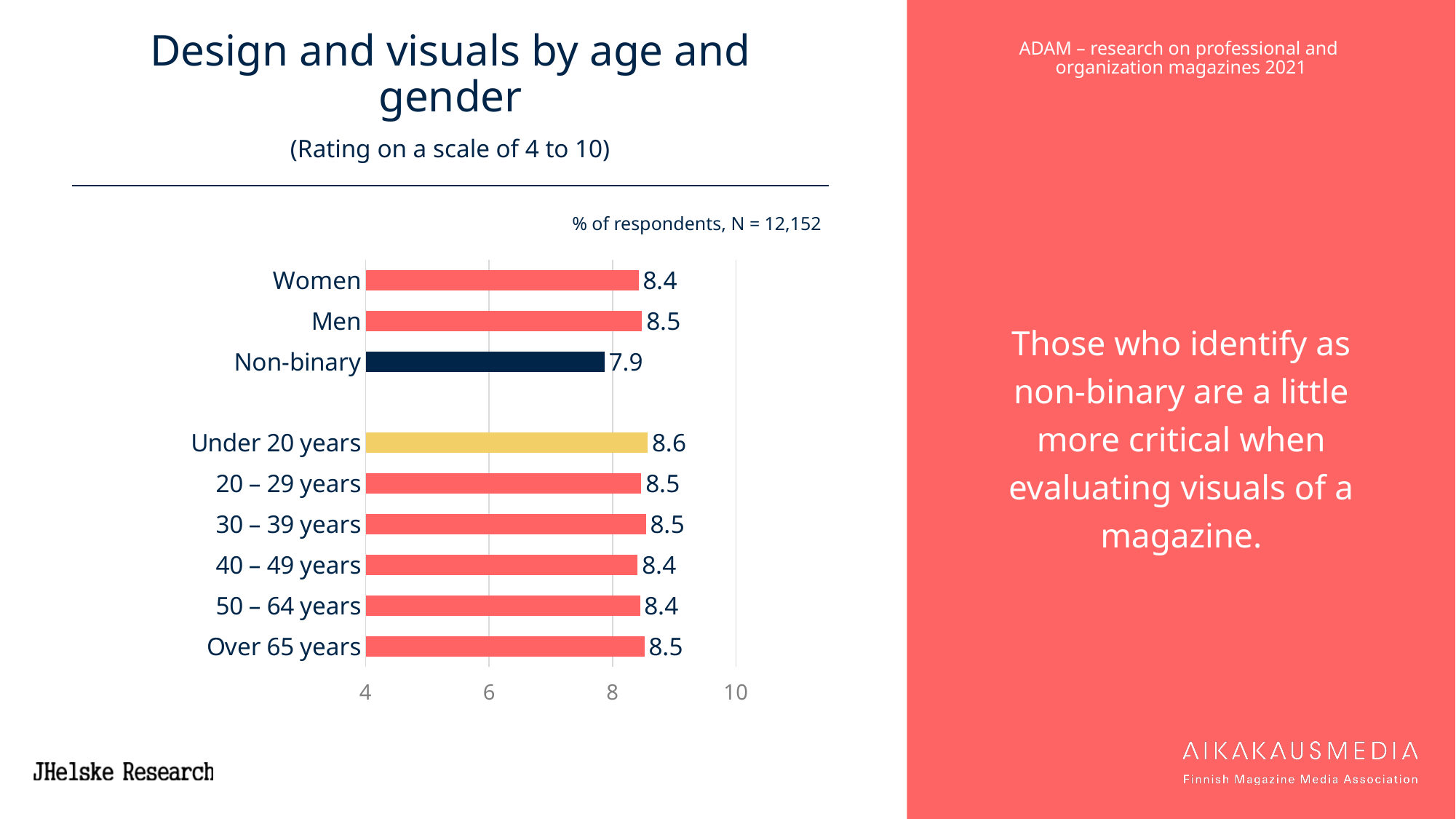
Which category has the highest rating? Under 20 years What is the difference between the ratings for Under 20 years and 40 – 49 years? 0.2 What is the rating for Non-binary respondents? 7.9 What is the difference between the ratings for Men and Non-binary? 0.6 What is the rating for Women? 8.4 Which has a higher rating, Women or Men? Men Is the value for Non-binary greater or less than 8? less What is the rating for 50 – 64 years? 8.4 Which category has the lowest rating? Non-binary What is the rating for Under 20 years? 8.6 How many categories are shown in the chart? 9 What kind of chart is shown on the slide? Bar chart